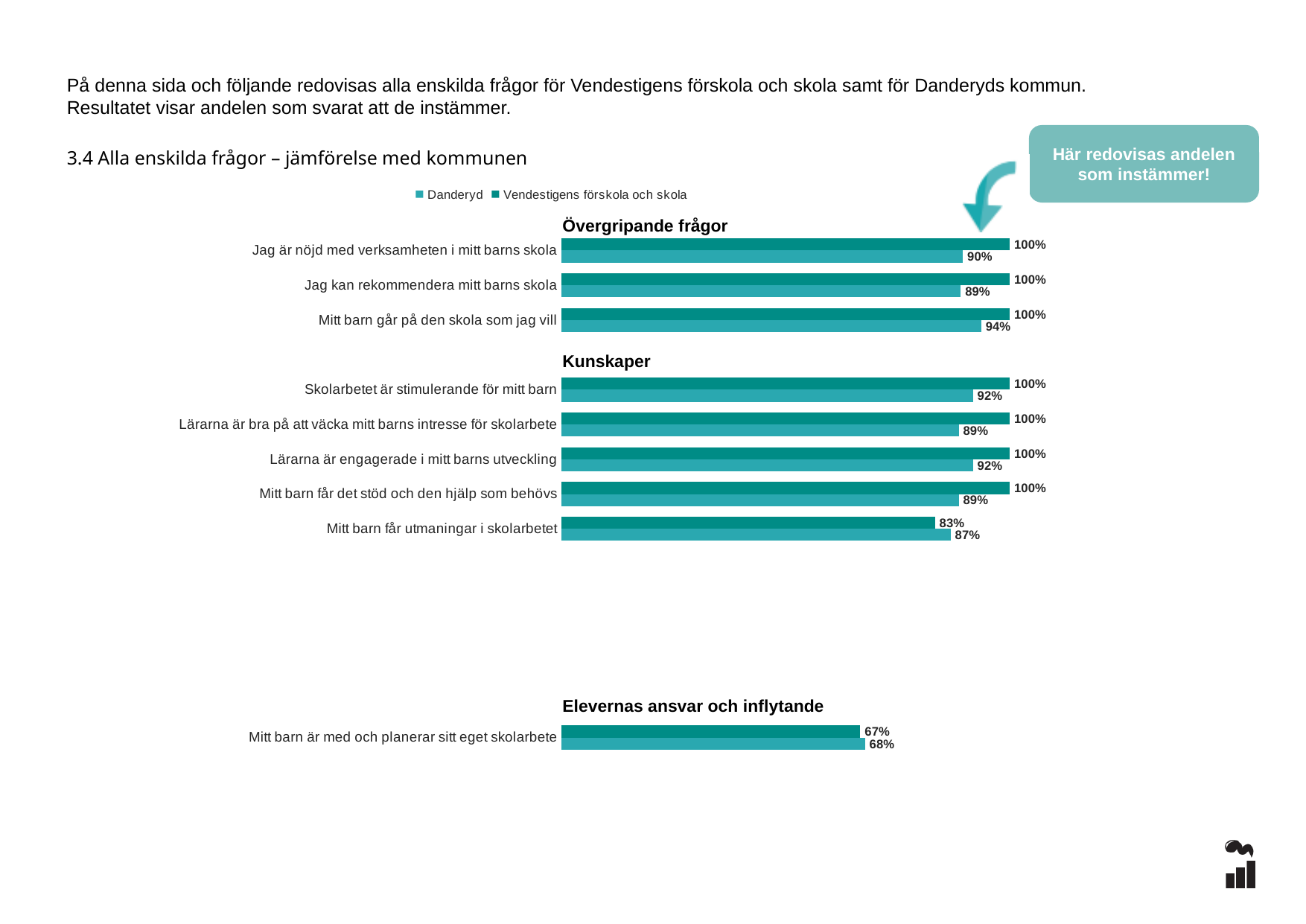
For "Mitt barn får utmaningar i skolarbetet", which series has the larger value, Danderyd or Vendestigens förskola och skola? Danderyd How many series does the legend list? 2 What is the Danderyd value for "Skolarbetet är stimulerande för mitt barn"? 92% What is the Danderyd value for "Mitt barn går på den skola som jag vill"? 94% Which two series are listed in the legend? Danderyd and Vendestigens förskola och skola How many questions are plotted in total on the slide? 9 What is the Vendestigens förskola och skola value for "Mitt barn får utmaningar i skolarbetet"? 83% What is the Danderyd value for "Mitt barn är med och planerar sitt eget skolarbete"? 68% What kind of chart is shown on the slide? Bar chart How many questions are shown under the heading "Kunskaper"? 5 What is the difference between the Vendestigens förskola och skola and Danderyd values for "Jag är nöjd med verksamheten i mitt barns skola"? 10 percentage points Which question has the lowest Danderyd value? Mitt barn är med och planerar sitt eget skolarbete